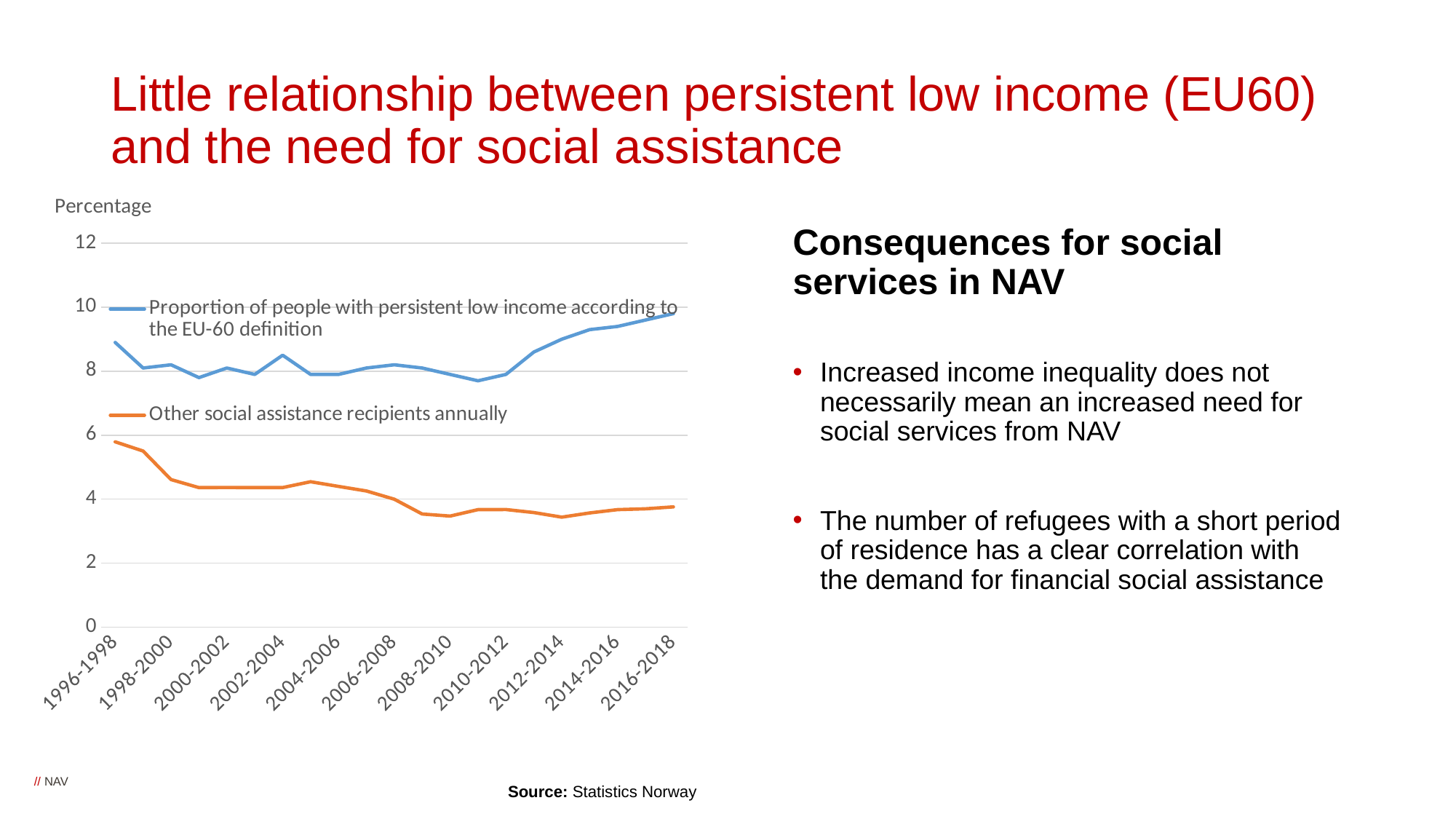
Is the value for 'Other social assistance recipients annually' in 1996-1998 greater or less than 6? less In which period does 'Proportion of people with persistent low income according to the EU-60 definition' reach its highest value? 2016-2018 How many period labels are shown on the x axis of the chart? 11 Is the value for 'Proportion of people with persistent low income according to the EU-60 definition' in 1996-1998 greater or less than 8? greater What kind of chart is shown on the slide? Line chart Is the value for 'Proportion of people with persistent low income according to the EU-60 definition' in 2016-2018 greater or less than 10? less In which period does 'Other social assistance recipients annually' reach its highest value? 1996-1998 Does the 'Other social assistance recipients annually' line rise or fall overall from 1996-1998 to 2016-2018? Fall Which series has the higher value in 2016-2018, 'Proportion of people with persistent low income according to the EU-60 definition' or 'Other social assistance recipients annually'? Proportion of people with persistent low income according to the EU-60 definition What is the label on the vertical axis of the chart? Percentage How many series does the chart show? 2